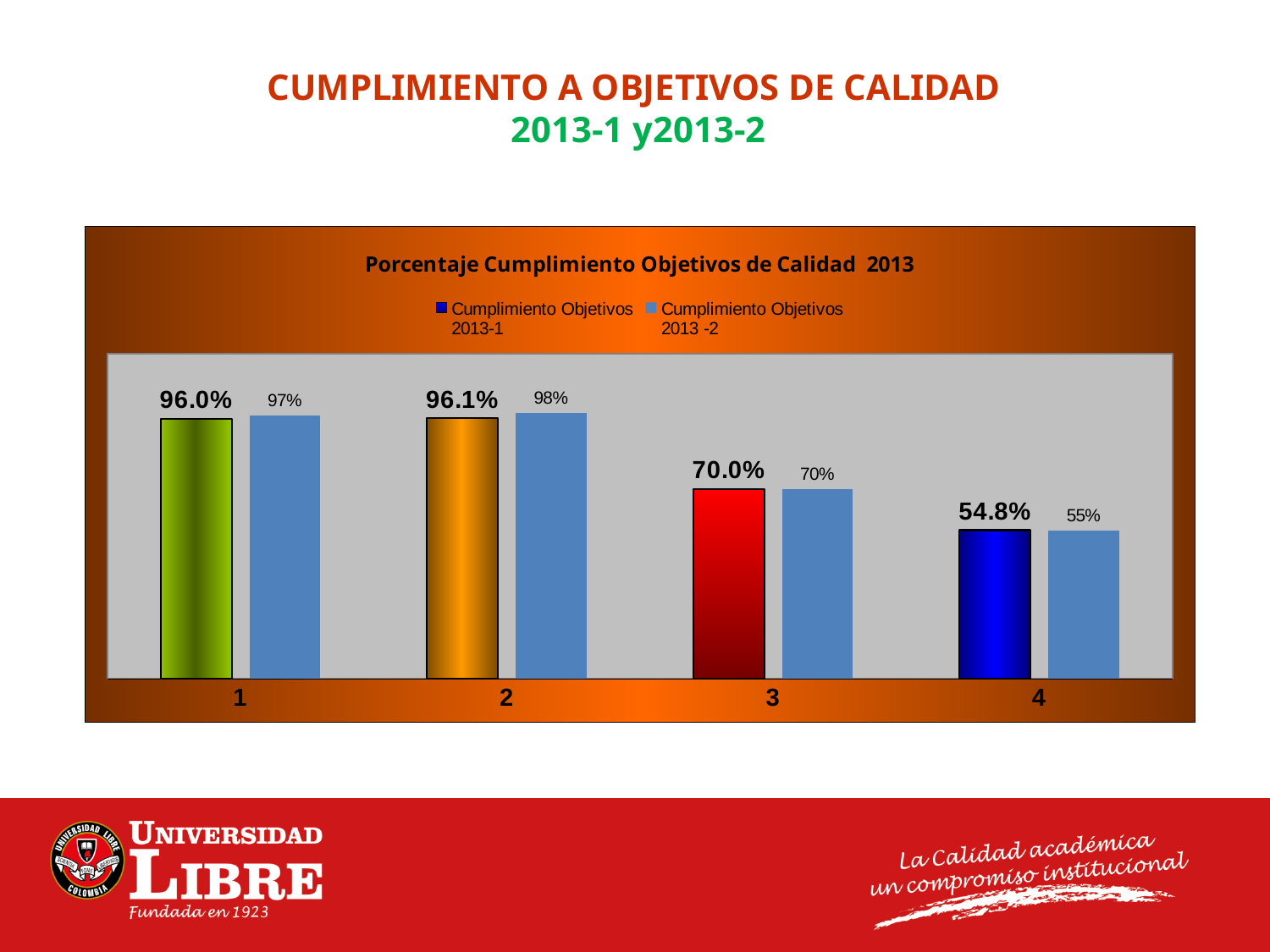
What is the difference between the Cumplimiento Objetivos 2013-1 values for category 1 and category 4? 41.2% What is the value for category 1 in the Cumplimiento Objetivos 2013-1 series? 96.0% Which category has the highest value in the Cumplimiento Objetivos 2013 -2 series? 2 What is the value for category 4 in the Cumplimiento Objetivos 2013-1 series? 54.8% Which category has the lowest value in the Cumplimiento Objetivos 2013-1 series? 4 What is the value for category 2 in the Cumplimiento Objetivos 2013 -2 series? 98% Which is larger: the Cumplimiento Objetivos 2013-1 value for category 3 or for category 4? category 3 What is the difference between the Cumplimiento Objetivos 2013 -2 values for category 2 and category 3? 28% How many categories are shown on the x axis? 4 What kind of chart is shown on the slide? bar chart What is the value for category 3 in the Cumplimiento Objetivos 2013 -2 series? 70% How many series does the legend list? 2